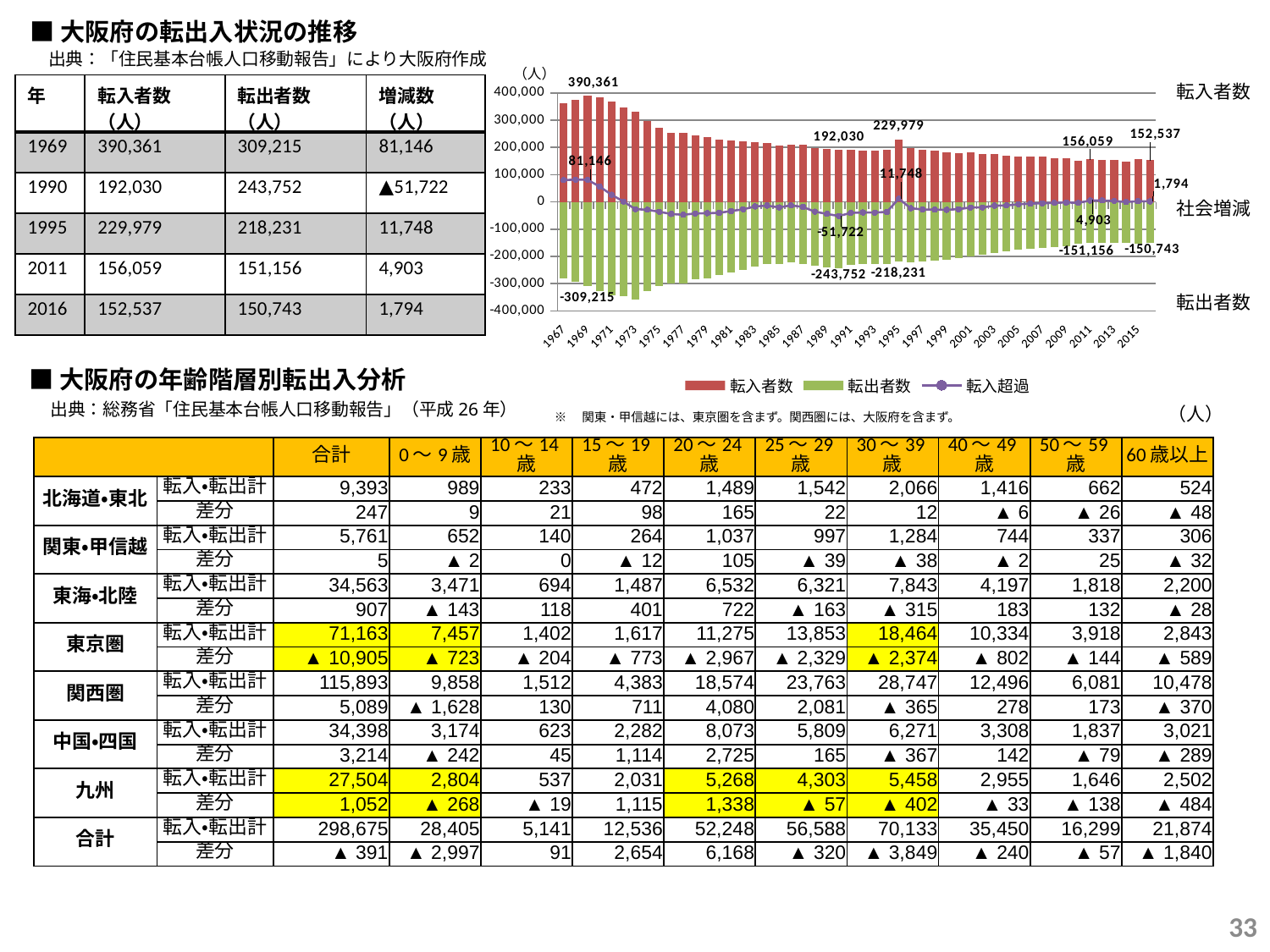
By how much does 転入者数 in 1969 exceed 転入者数 in 2016? 237,824 What is the value labelled for 転出者数 in 2011 on the chart? -151,156 What is the value of 転入超過 in 1995 on the chart? 11,748 What is the value of 転入者数 in 1969 on the chart? 390,361 How many series does the chart legend list? 3 Does 転入者数 generally rise or fall from 1967 to 2016 on the chart? fall Is the value for 転入者数 in 1967 greater or less than 300,000? greater What kind of chart is shown on the slide? bar chart with a line What is the value of 転入者数 in 2016 on the chart? 152,537 Which year has the larger 転入者数, 1990 or 1995? 1995 What is the value labelled for 転出者数 in 1969 on the chart? -309,215 What is the value of 転入超過 in 1990 on the chart? -51,722